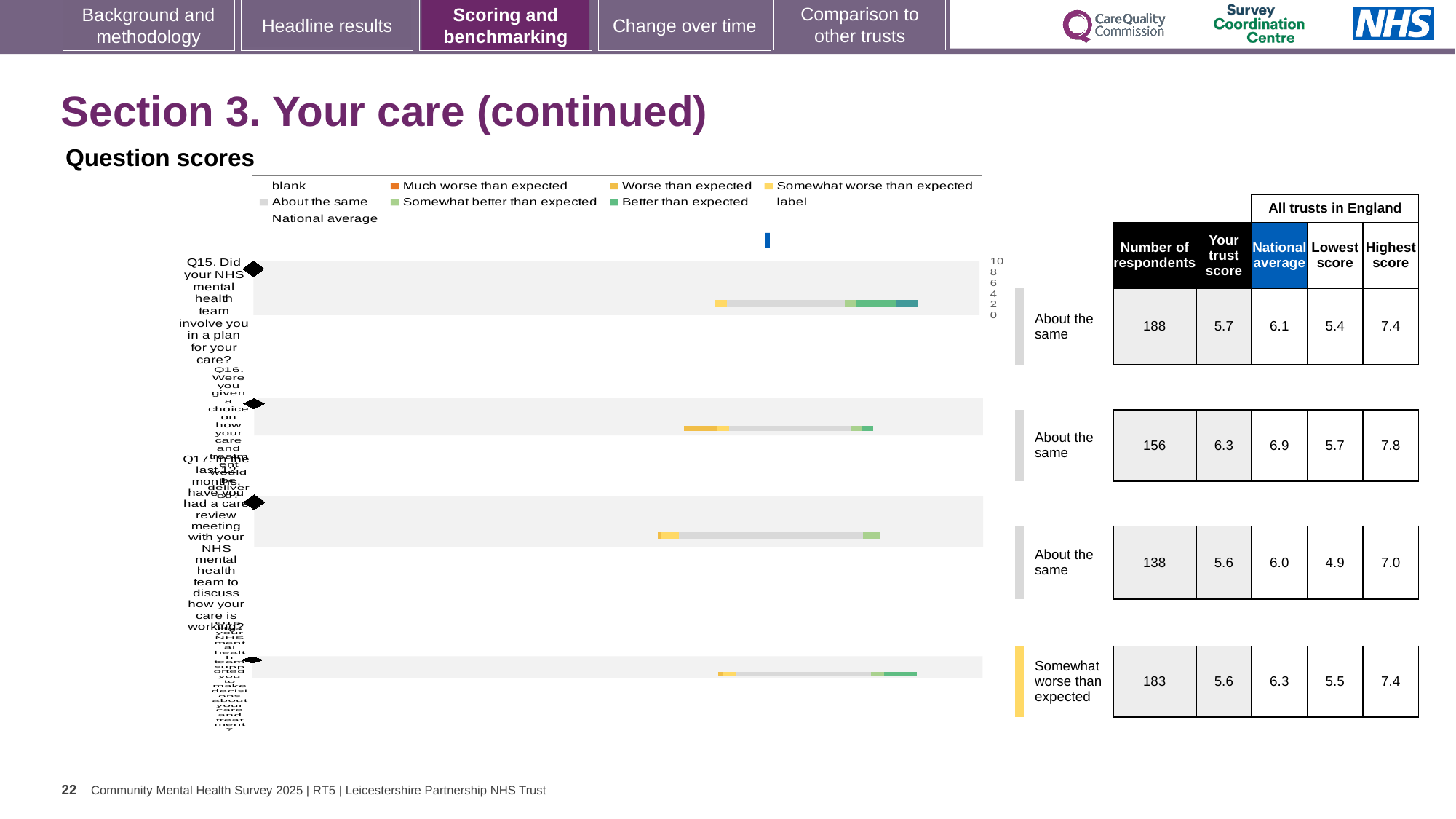
Which question has the highest number of respondents in the table beside the chart? Q15 In the table beside the Question scores chart, how many respondents answered Q17? 138 What is the title of the chart on this slide? Question scores In the table beside the Question scores chart, what is the Highest score for Q18? 7.4 What benchmark category is shown for Q18 next to the chart? Somewhat worse than expected What kind of chart is used to show the question scores on this slide? bar chart Which question has the lowest 'Lowest score' in the table beside the chart? Q17 In the table beside the Question scores chart, what is the 'Your trust score' for Q15? 5.7 Is the trust score for Q16 larger or smaller than the trust score for Q15 in the table beside the chart? larger How many question bars are plotted in the Question scores chart? 4 In the table beside the Question scores chart, what is the National average for Q16? 6.9 What is the difference between the National average and the trust score for Q16 in the table beside the chart? 0.6